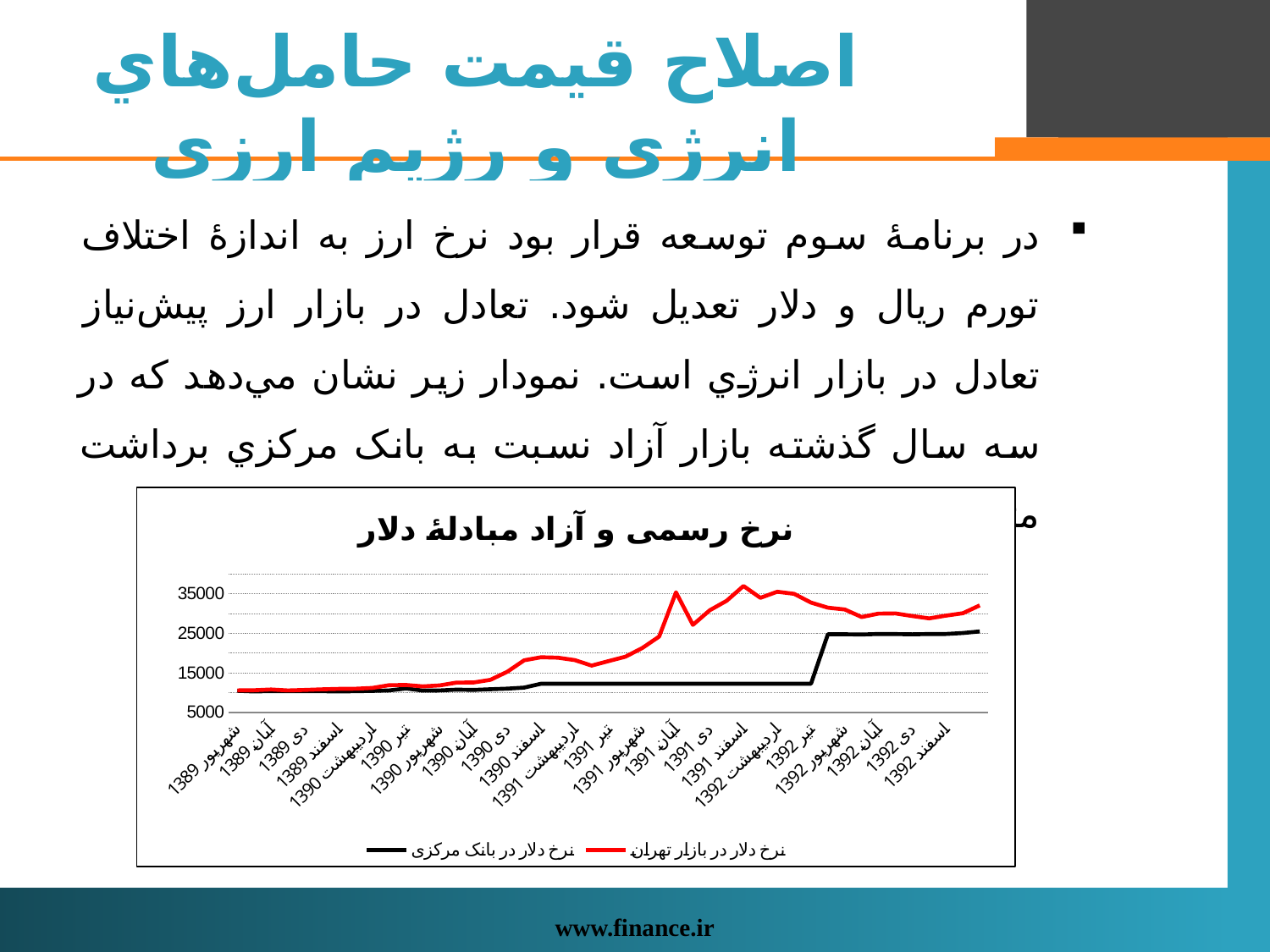
Is the value of نرخ دلار در بانک مرکزی at اسفند 1392 greater or less than 15000? greater Does the نرخ دلار در بانک مرکزی series rise or fall overall from شهریور 1389 to اسفند 1392? rise Which series reaches the highest value anywhere on the chart? نرخ دلار در بازار تهران Is the value of نرخ دلار در بانک مرکزی at شهریور 1389 greater or less than 15000? less What is the title of the chart? نرخ رسمی و آزاد مبادلۀ دلار Which series is drawn in red? نرخ دلار در بازار تهران Is the value of نرخ دلار در بازار تهران at دی 1391 greater or less than 25000? greater How many series does the legend list? 2 At اسفند 1392, which series has the higher value, نرخ دلار در بازار تهران or نرخ دلار در بانک مرکزی? نرخ دلار در بازار تهران What kind of chart is shown on the slide? line chart How many time-period labels are shown on the x axis? 22